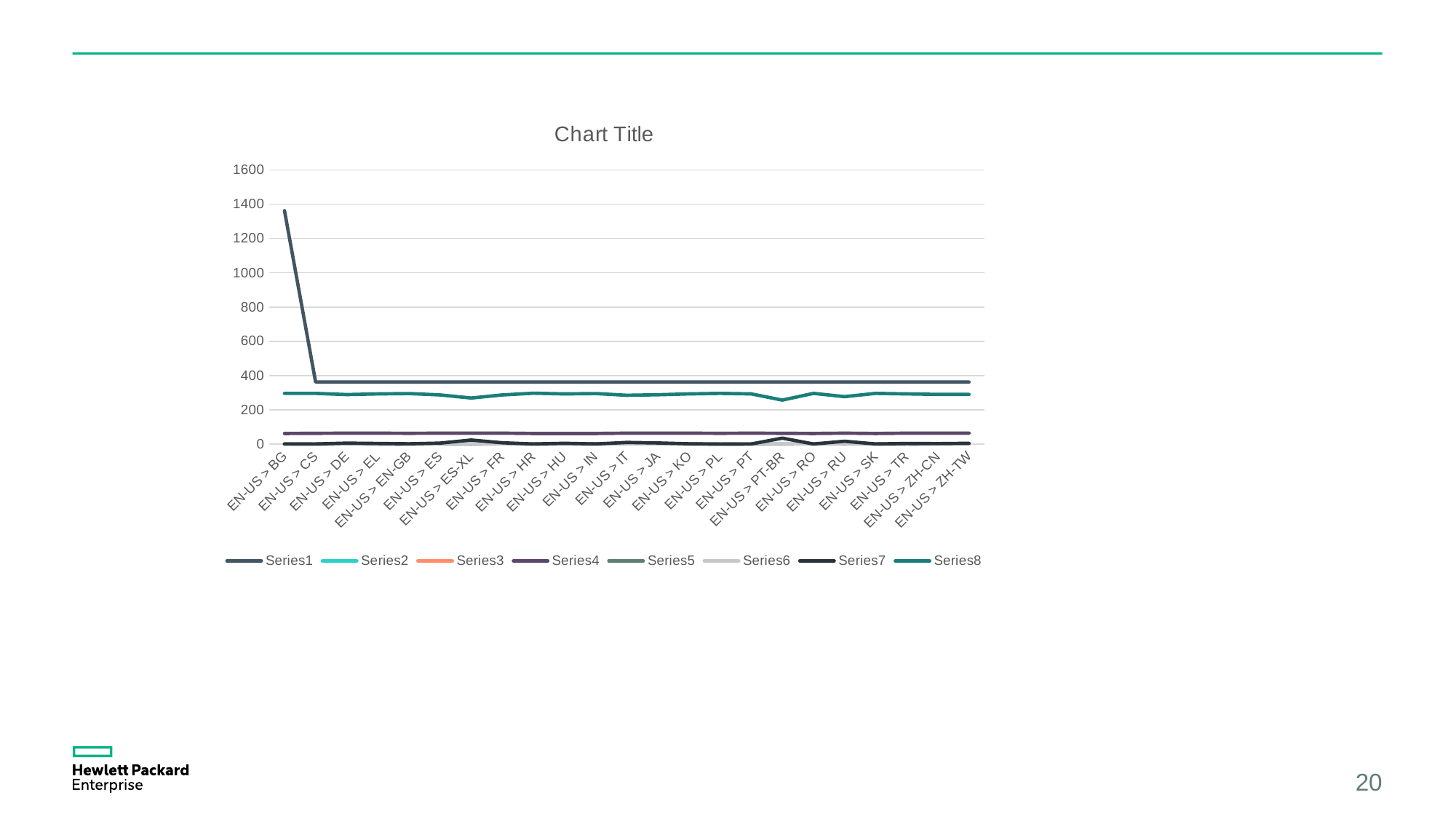
What kind of chart is shown on the slide? line chart How many categories are shown along the x axis? 23 Is the value of Series1 at EN-US > BG greater or less than 1200? greater Is the value of Series1 at EN-US > CS greater or less than 200? greater Is the value of Series4 at EN-US > JA greater or less than 200? less Does Series1 rise or fall from EN-US > BG to EN-US > CS? fall At which category does Series1 reach its highest value? EN-US > BG What is the first category label on the x axis? EN-US > BG How many series does the legend list? 8 What is the title of the chart? Chart Title Which is larger at EN-US > DE: the value of Series1 or the value of Series8? Series1